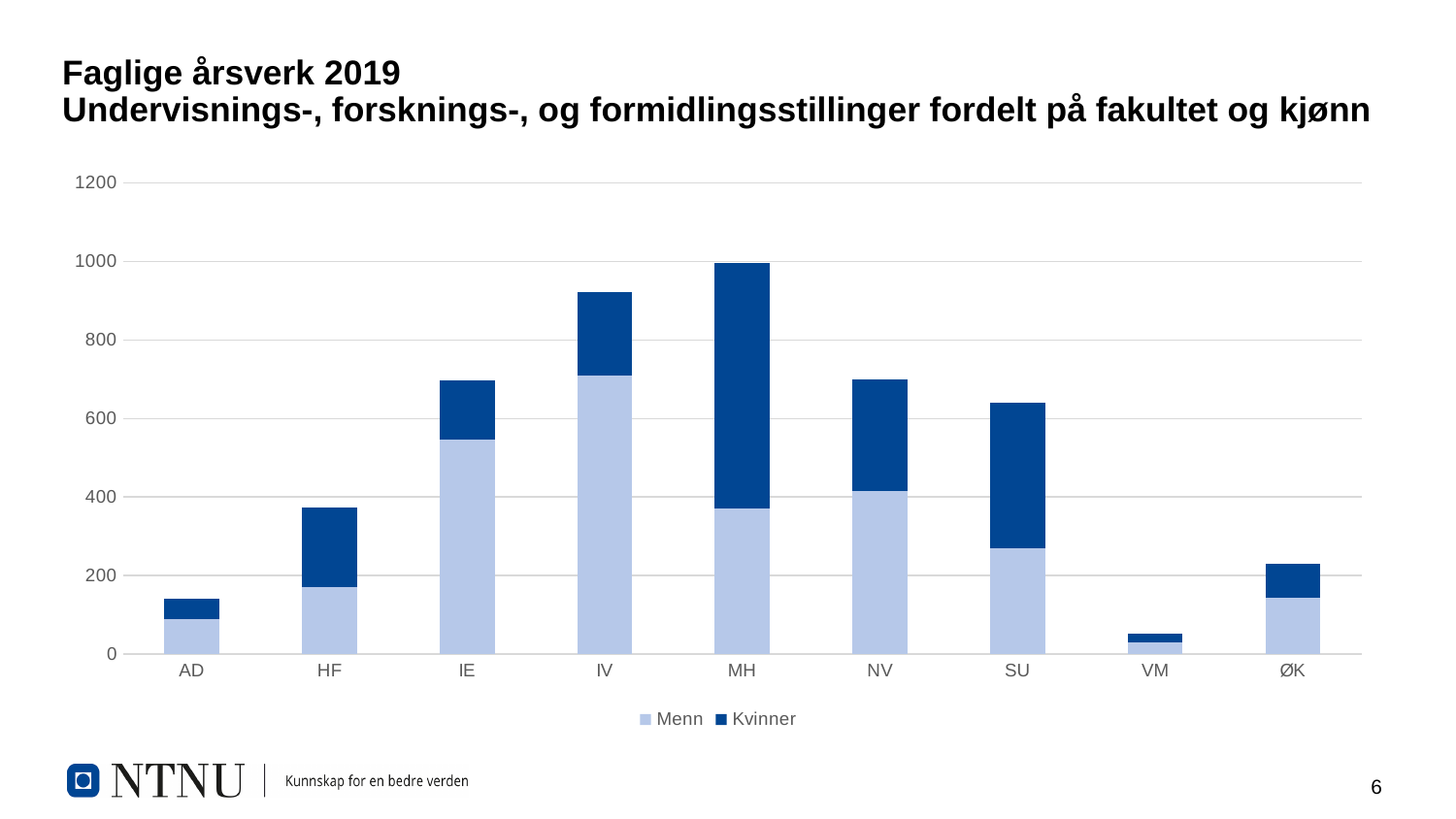
Is the total value for HF greater or less than 400? less Which is larger for MH, the Menn segment or the Kvinner segment? Kvinner Which faculty has the lowest total bar? VM Which is larger for IE, the Menn segment or the Kvinner segment? Menn Is the Menn value for IV greater or less than 600? greater How many series does the legend list? 2 What are the two legend entries of the chart? Menn and Kvinner How many faculties (categories) are shown on the x axis? 9 What kind of chart is shown on the slide? stacked bar chart Which faculty has the highest total bar? MH Is the total value for SU greater or less than 600? greater